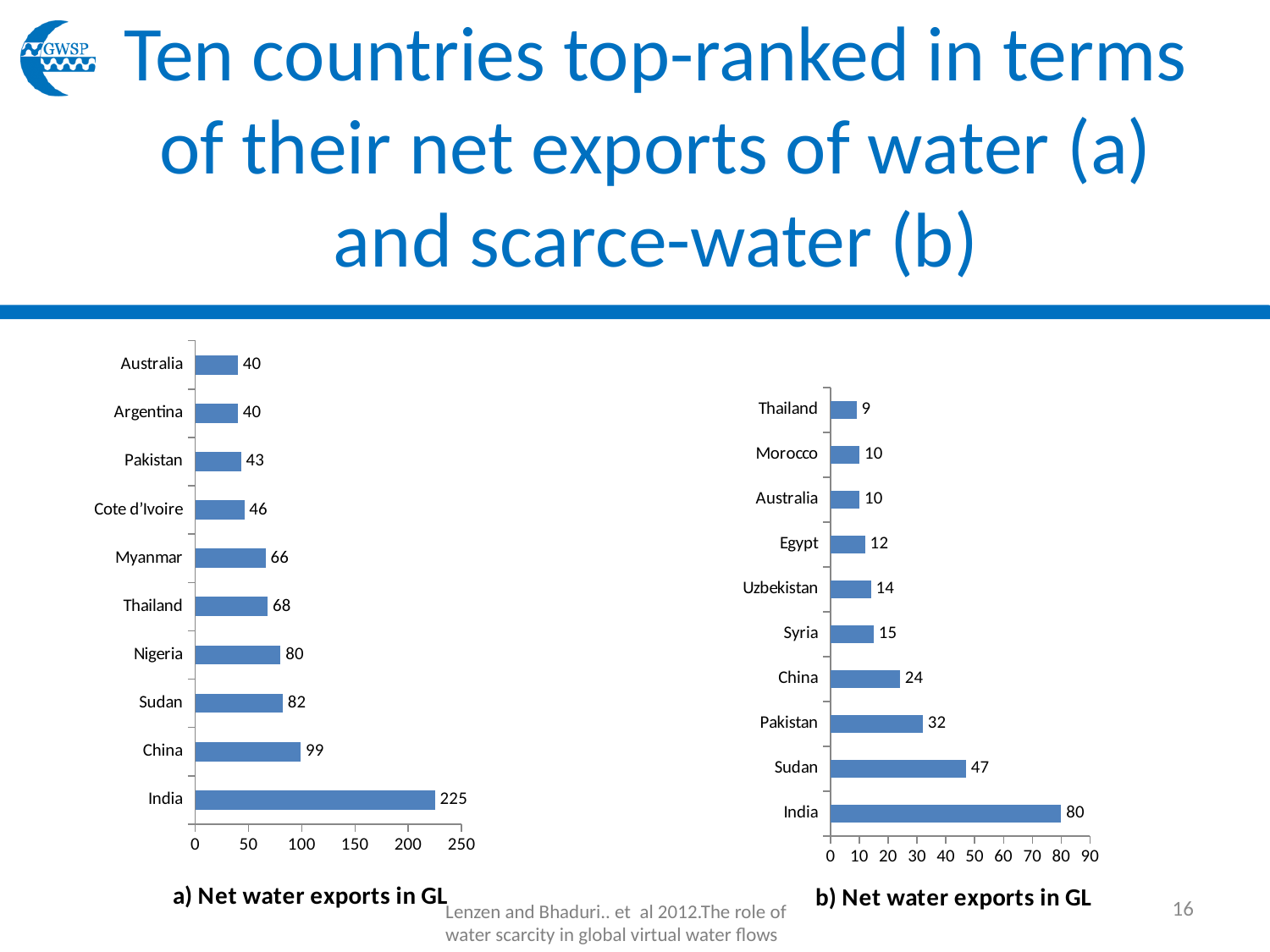
In the left chart (a), which country has the highest value? India In the right chart (b), what is the difference between the values for India and Pakistan? 48 In the left chart (a), what is the difference between the values for India and China? 126 What type of chart is the right chart (b)? Bar chart In the left chart (a), what is the net water export value for India? 225 In the right chart (b), which country has the lowest value? Thailand In the right chart (b), which is larger, the value for China or the value for Syria? China What is the caption printed below the right chart (b)? b) Net water exports in GL In the left chart (a), what is the value for Myanmar? 66 In the left chart (a), which is larger, the value for Sudan or the value for Nigeria? Sudan In the right chart (b), what is the value for Sudan? 47 How many countries are shown in the left chart (a)? 10